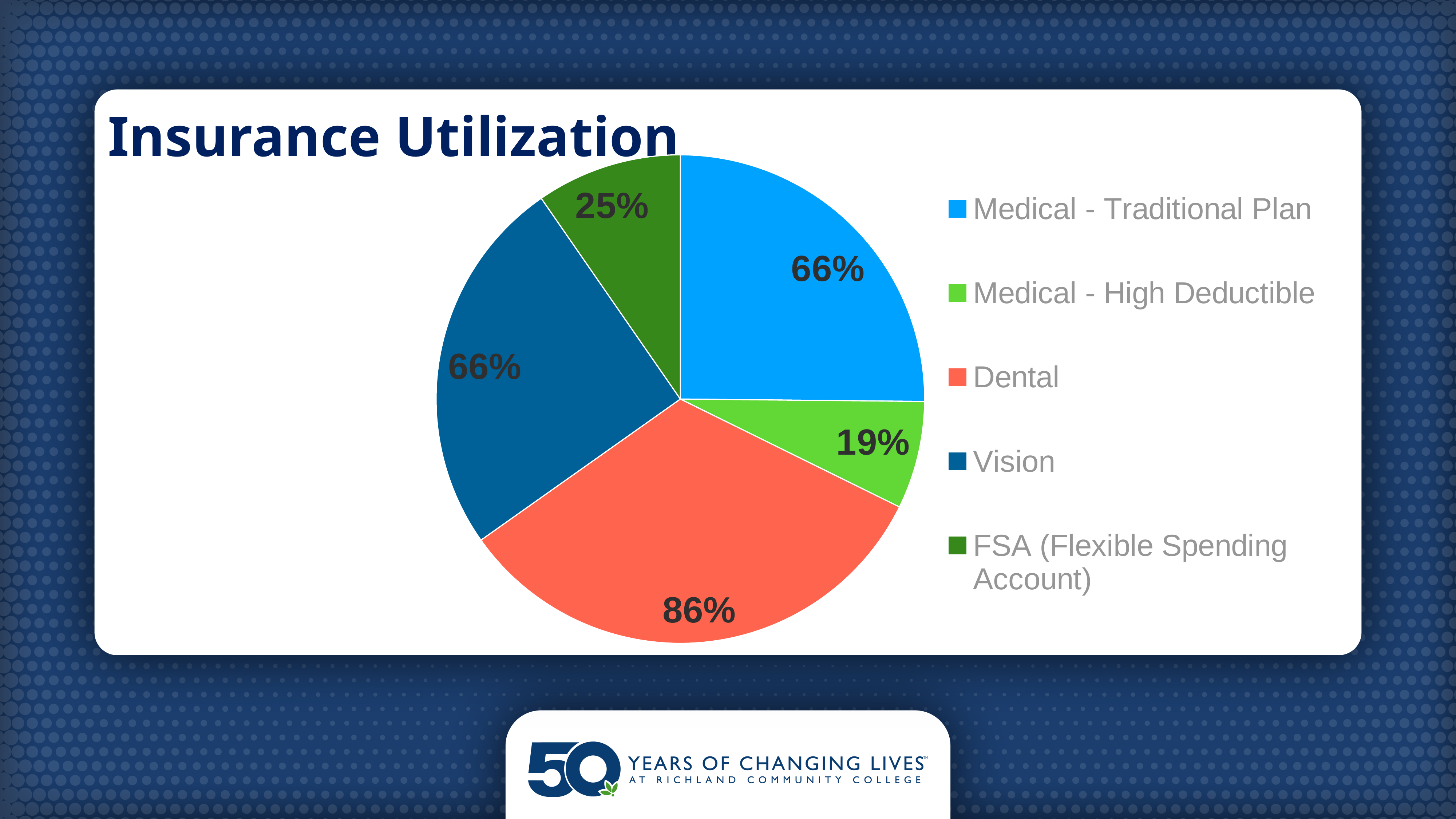
What is the difference between the labelled values for Dental and Medical - High Deductible? 67 percentage points What value is labelled on the FSA (Flexible Spending Account) slice? 25% How many categories does the legend list? 5 Which has the larger labelled value, Dental or FSA (Flexible Spending Account)? Dental What value is labelled on the Vision slice? 66% What value is labelled on the Dental slice? 86% What value is labelled on the Medical - High Deductible slice? 19% Which category has the highest labelled value? Dental What value is labelled on the Medical - Traditional Plan slice? 66% What is the title of the chart? Insurance Utilization Which category has the lowest labelled value? Medical - High Deductible What kind of chart is shown on the slide? pie chart